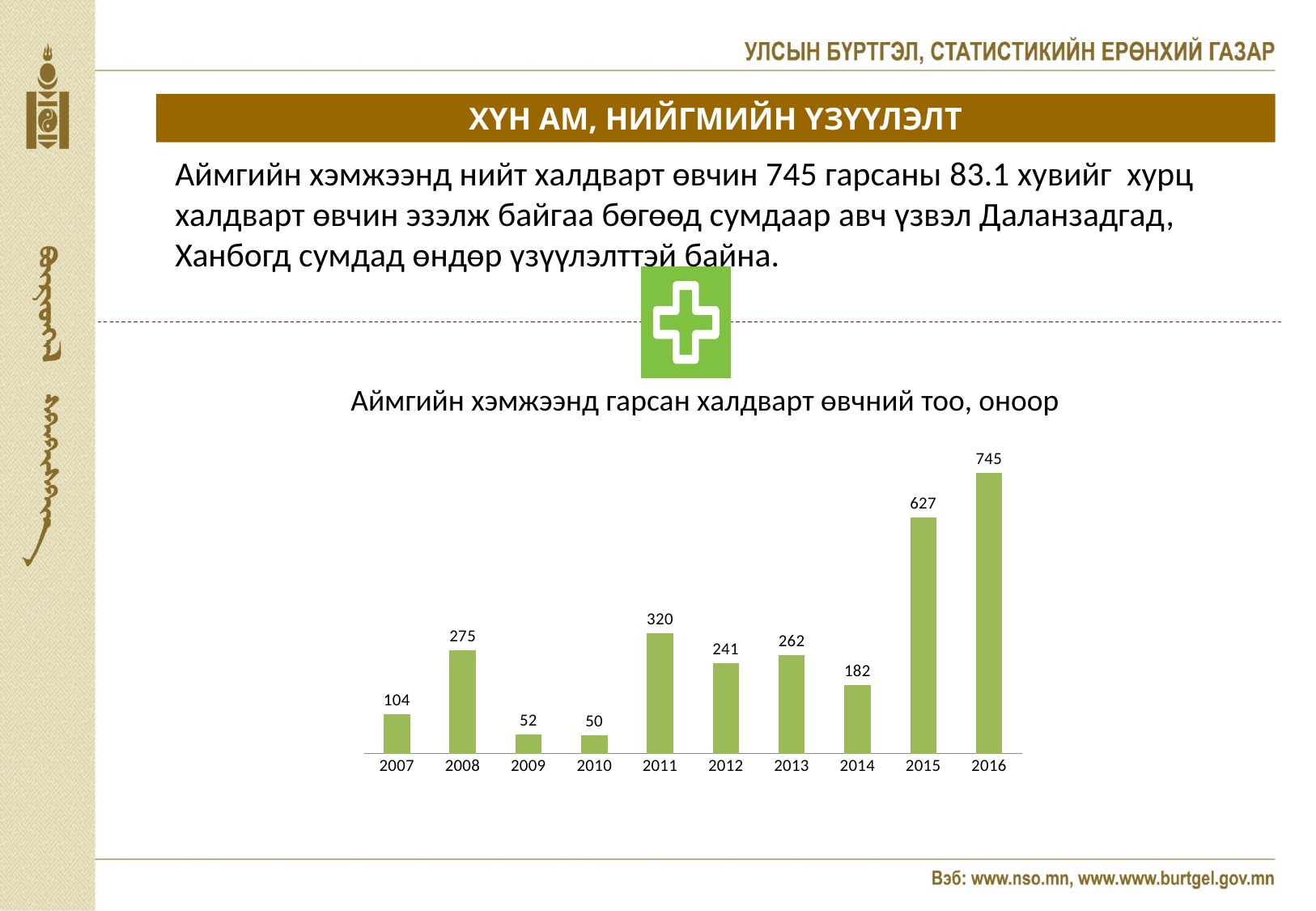
What is the value for 2016? 745 What is the difference between the values for 2011 and 2007? 216 What is the title of the chart? Аймгийн хэмжээнд гарсан халдварт өвчний тоо, оноор What is the value for 2012? 241 Which year has the highest value? 2016 Which is larger, the value for 2013 or the value for 2014? 2013 Do the values rise or fall from 2014 to 2016? rise What is the value for 2009? 52 What kind of chart is this? bar chart How many years are shown on the x axis? 10 What is the difference between the values for 2016 and 2015? 118 Which year has the lowest value? 2010